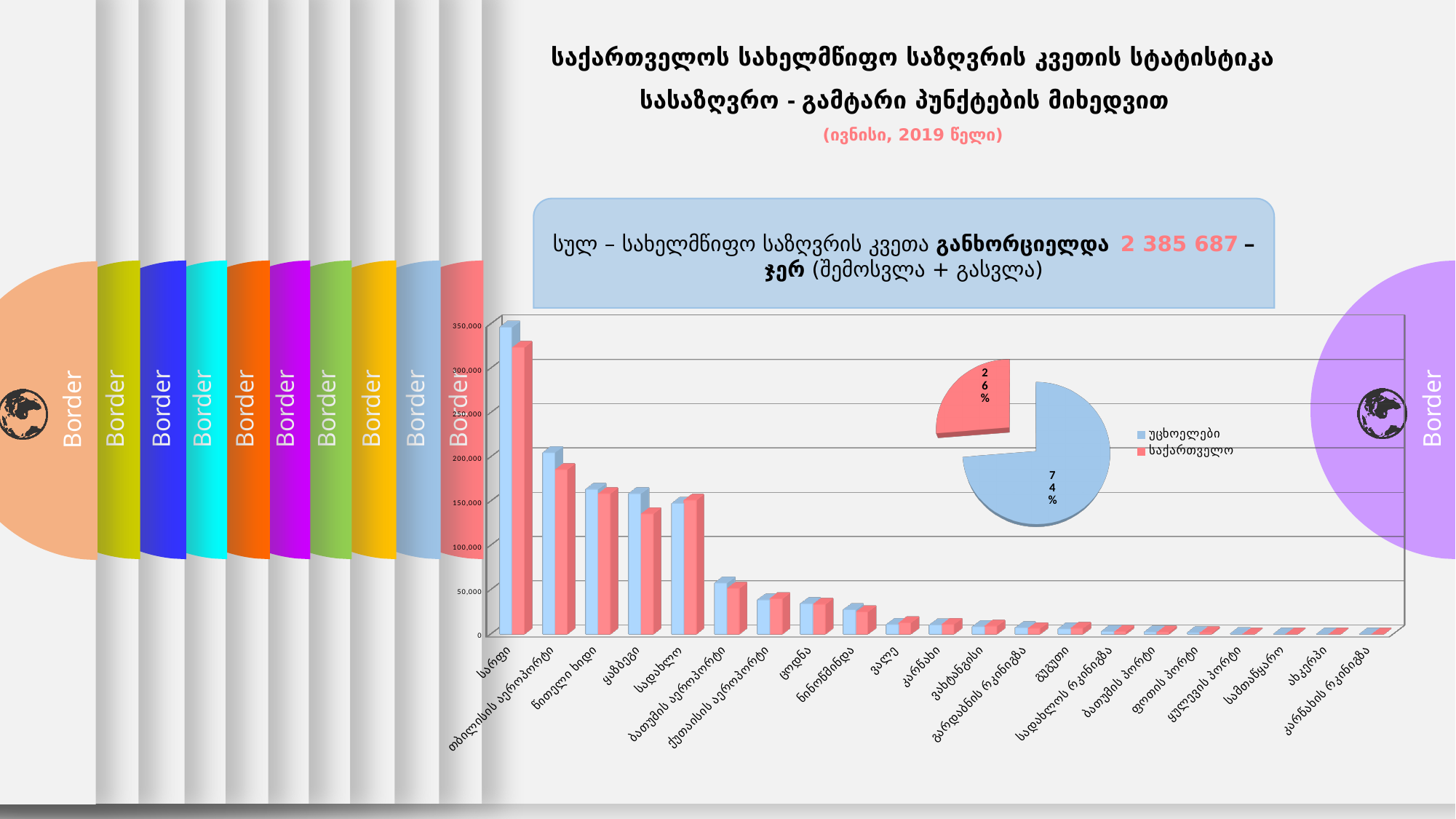
In the pie chart, what is the difference in percentage points between the უცხოელები slice and the საქართველო slice? 48 In the pie chart, which slice is larger, უცხოელები or საქართველო? უცხოელები In the pie chart, what share is shown for საქართველო? 26% How many entries does the pie chart's legend list? 2 In the bar chart, which border crossing point has the highest values? სარფი In the bar chart, is the red bar for ყაზბეგი greater or less than 150,000? less In the bar chart, do the values generally rise or fall moving from left to right along the x axis? Fall In the bar chart, how many border crossing points are listed along the x axis? 21 What kind of chart is the large chart at the bottom with the border crossing points along the x axis? Bar chart What kind of chart is the chart on the right with the 74% and 26% slices? Pie chart In the bar chart, is the blue bar for სარფი greater or less than 300,000? greater In the pie chart, what share is shown for უცხოელები? 74%